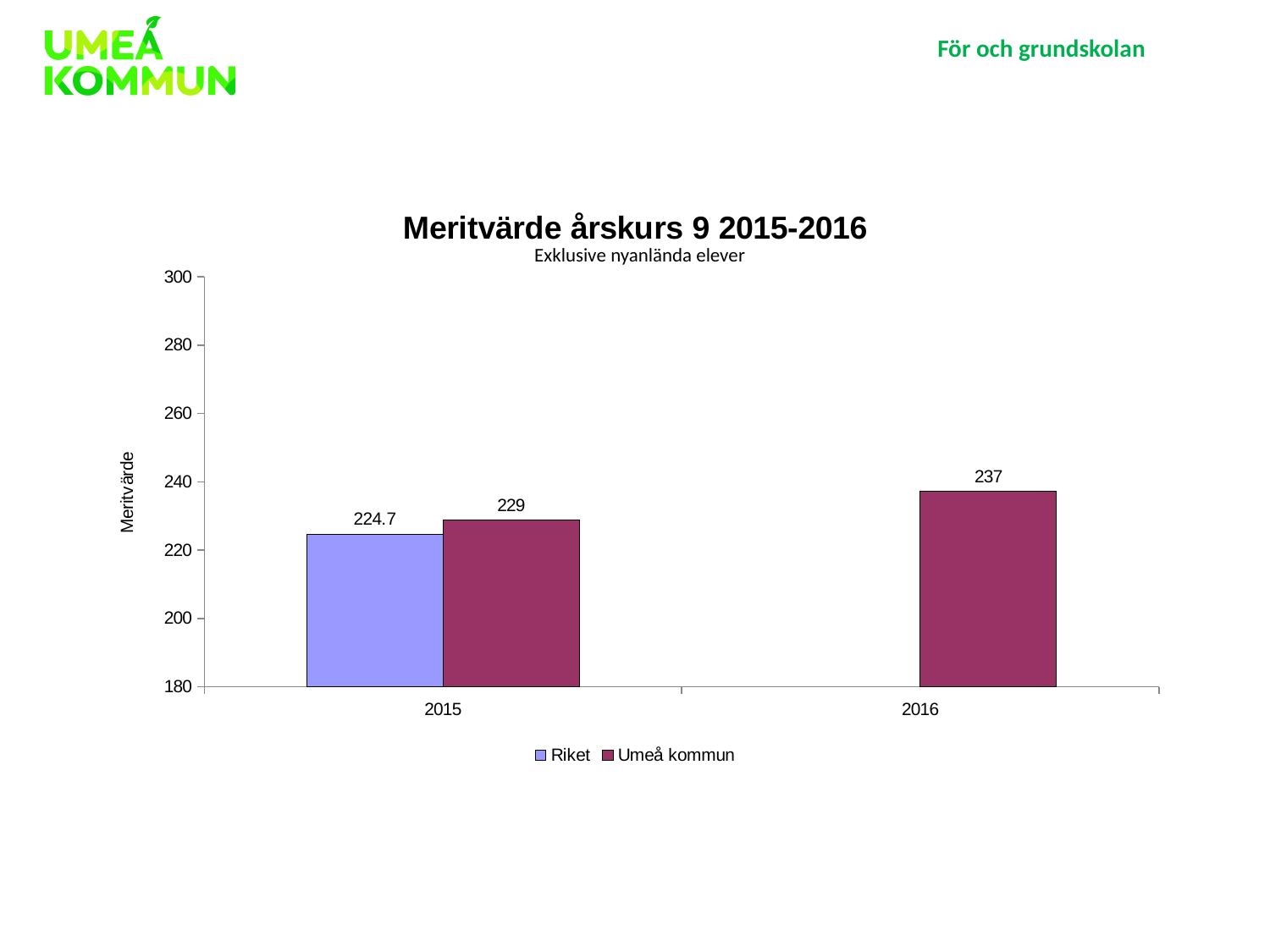
Which bar has the highest value on the chart? Umeå kommun 2016 Is the value for Umeå kommun in 2016 greater or less than 240? less What is the value for Umeå kommun in 2015? 229 What is the difference between Umeå kommun and Riket in 2015? 4.3 Which is larger in 2015, Riket or Umeå kommun? Umeå kommun What is the title of the chart? Meritvärde årskurs 9 2015-2016 By how much did the Umeå kommun value increase from 2015 to 2016? 8 How many series does the legend list? 2 What is the value for Umeå kommun in 2016? 237 What kind of chart is shown on the slide? bar chart Which bar has the lowest value on the chart? Riket 2015 What is the value for Riket in 2015? 224.7